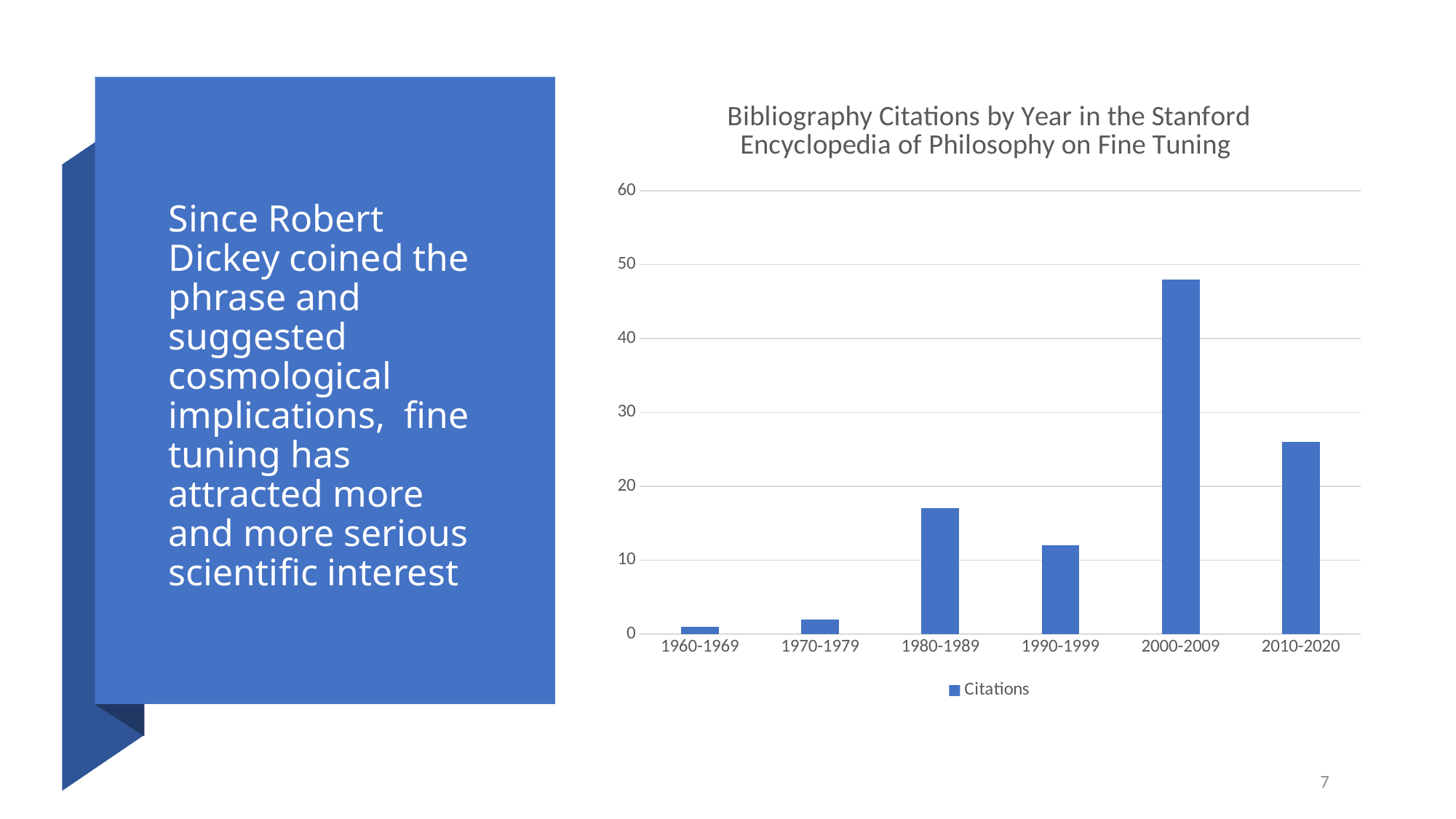
Is the value for 1980-1989 greater or less than 20? less How many decade categories are shown on the x axis? 6 Which decade has the highest number of citations? 2000-2009 What type of chart is shown on the slide? bar chart Is the value for 1970-1979 greater or less than 10? less What is the name of the series shown in the legend? Citations Is the value for 2010-2020 greater or less than 20? greater Which decade has the lowest number of citations? 1960-1969 Which has more citations, 1980-1989 or 1990-1999? 1980-1989 How many series does the legend list? 1 Which has more citations, 2010-2020 or 2000-2009? 2000-2009